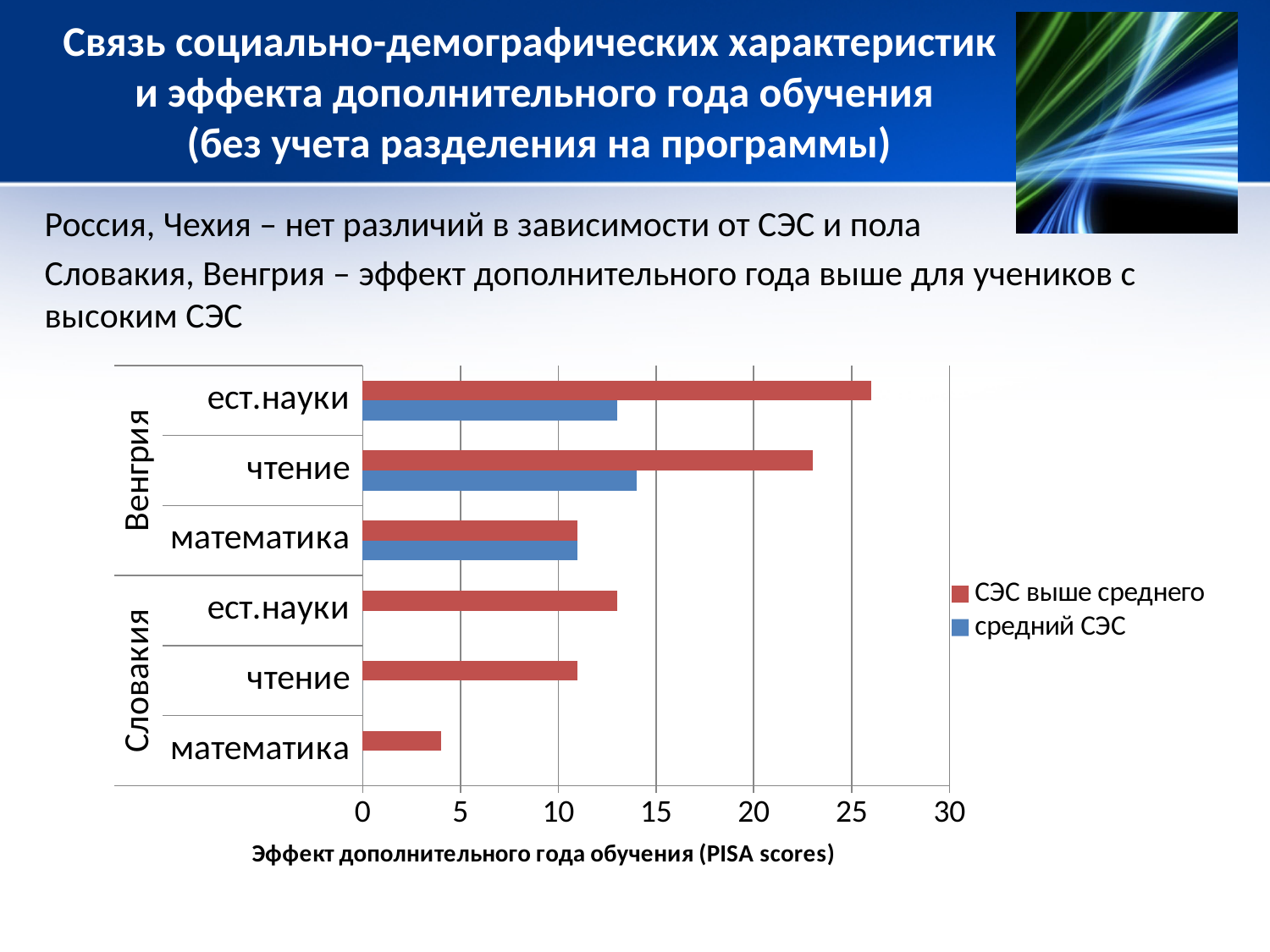
What is the title of the horizontal axis of the chart? Эффект дополнительного года обучения (PISA scores) Which is larger for 'СЭС выше среднего': Словакия ест.науки or Словакия математика? Словакия ест.науки Is the value for 'средний СЭС' in Венгрия чтение greater or less than 15? less How many subject categories are plotted on the chart in total? 6 Is the value for 'СЭС выше среднего' in Венгрия ест.науки greater or less than 25? greater For Венгрия ест.науки, which series has the larger value: 'СЭС выше среднего' or 'средний СЭС'? СЭС выше среднего Is the value for 'СЭС выше среднего' in Венгрия чтение greater or less than 20? greater Which category has the highest value for the series 'СЭС выше среднего'? Венгрия, ест.науки What kind of chart is shown on the slide? bar chart How many series does the legend list? 2 Which category has the lowest value for the series 'СЭС выше среднего'? Словакия, математика